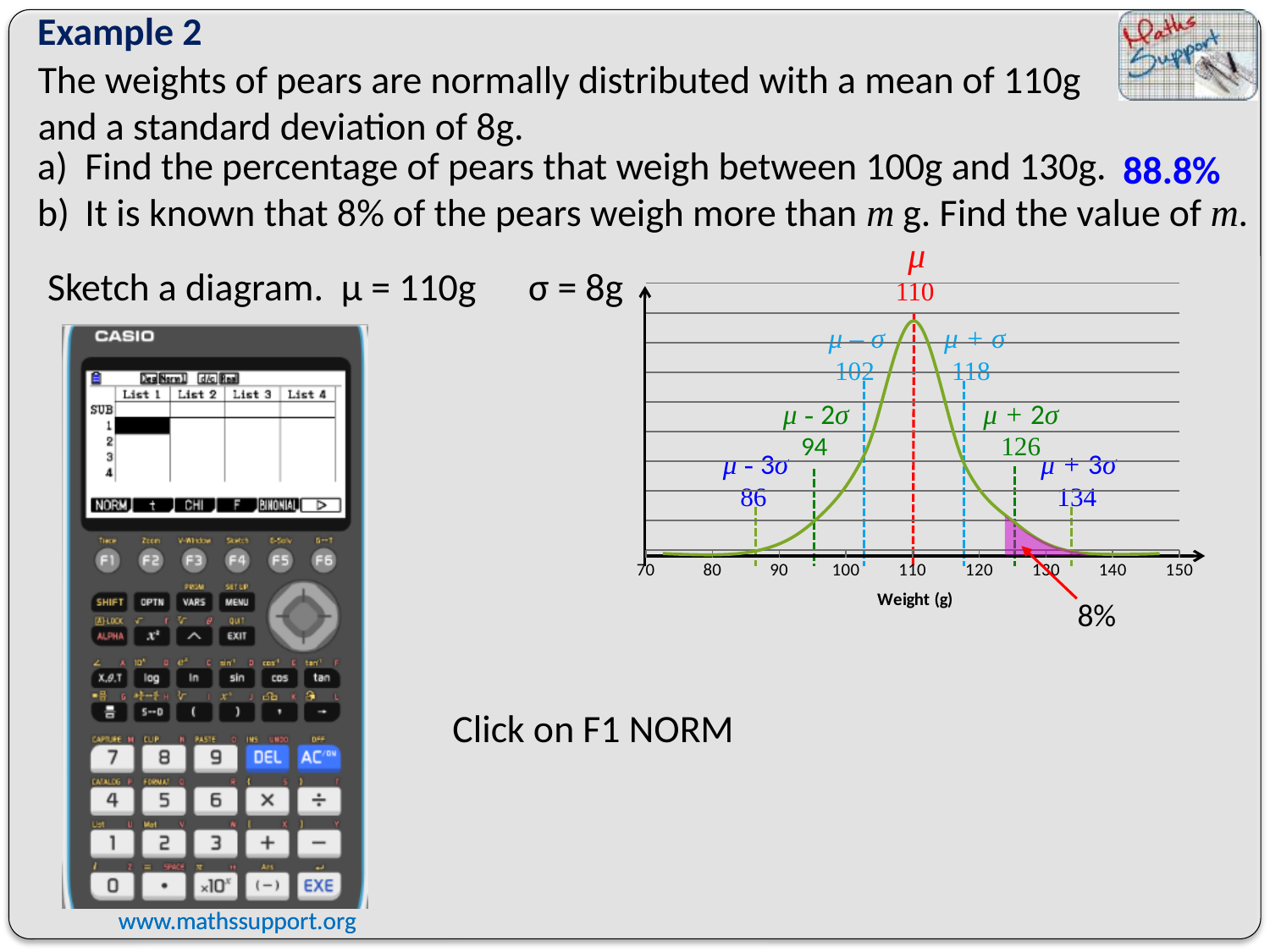
What value is labelled at μ + 3σ on the chart? 134 What value is labelled at μ – 3σ on the chart? 86 What kind of chart is shown on the slide? line chart What percentage is labelled for the shaded region under the curve? 8% What value is labelled at μ + 2σ on the chart? 126 What value is labelled at μ – 2σ on the chart? 94 What value is labelled at μ + σ on the chart? 118 How many tick labels are shown on the horizontal axis of the chart? 9 What is the title of the horizontal axis on the chart? Weight (g) What value is labelled at the mean μ on the chart? 110 What is the difference between the values labelled at μ + σ and μ – σ? 16 What value is labelled at μ – σ on the chart? 102